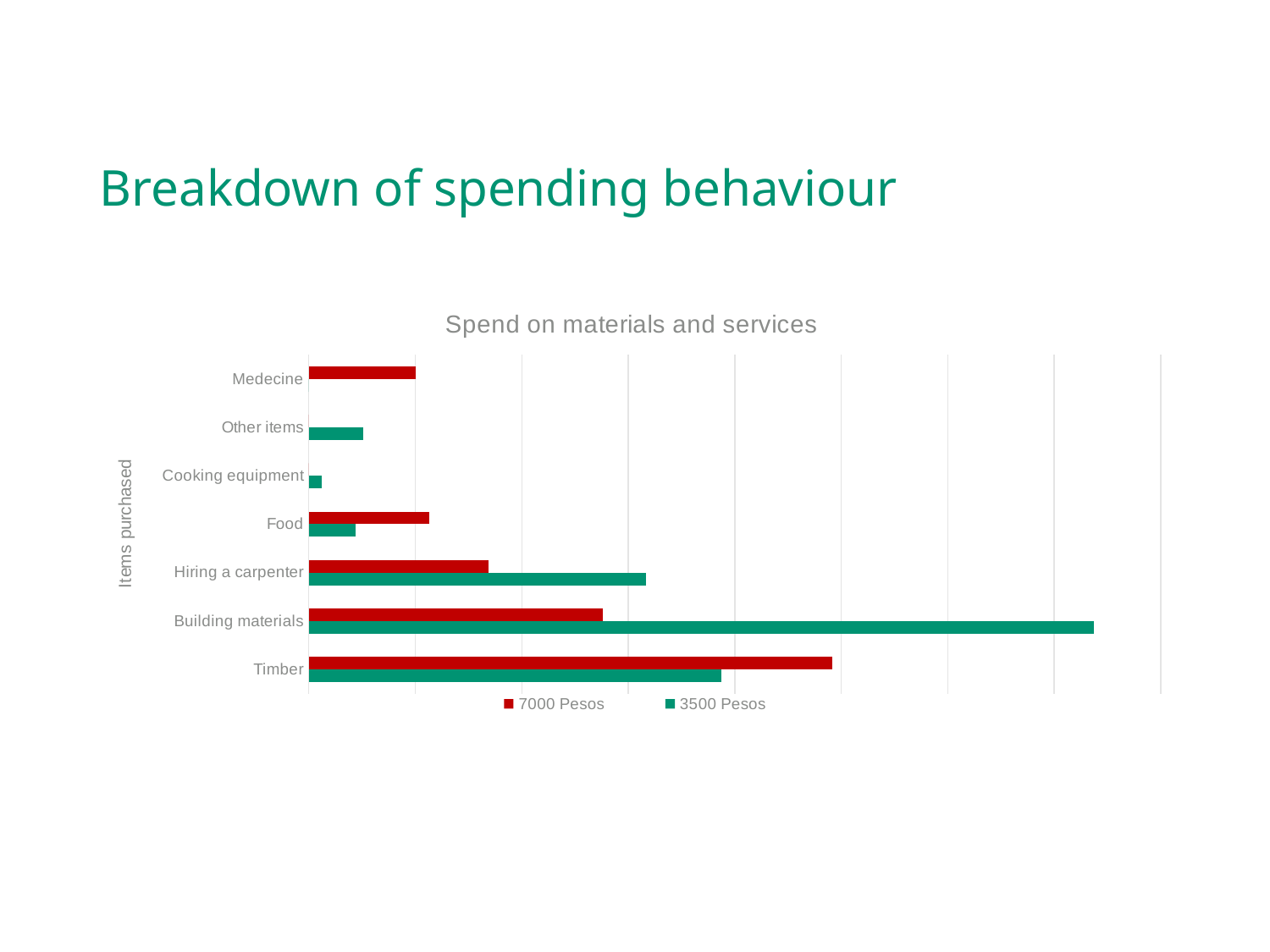
In the 7000 Pesos series, which is larger: Timber or Building materials? Timber For Food, which series has the larger value: 7000 Pesos or 3500 Pesos? 7000 Pesos Which item has the longest 3500 Pesos bar? Building materials How many categories (items purchased) are listed on the chart? 7 For Hiring a carpenter, which series has the larger value: 7000 Pesos or 3500 Pesos? 3500 Pesos What kind of chart is shown on the slide? Bar chart Which item has the longest 7000 Pesos bar? Timber What is the title of the chart? Spend on materials and services What is the label on the vertical axis of the chart? Items purchased How many series does the chart's legend list? 2